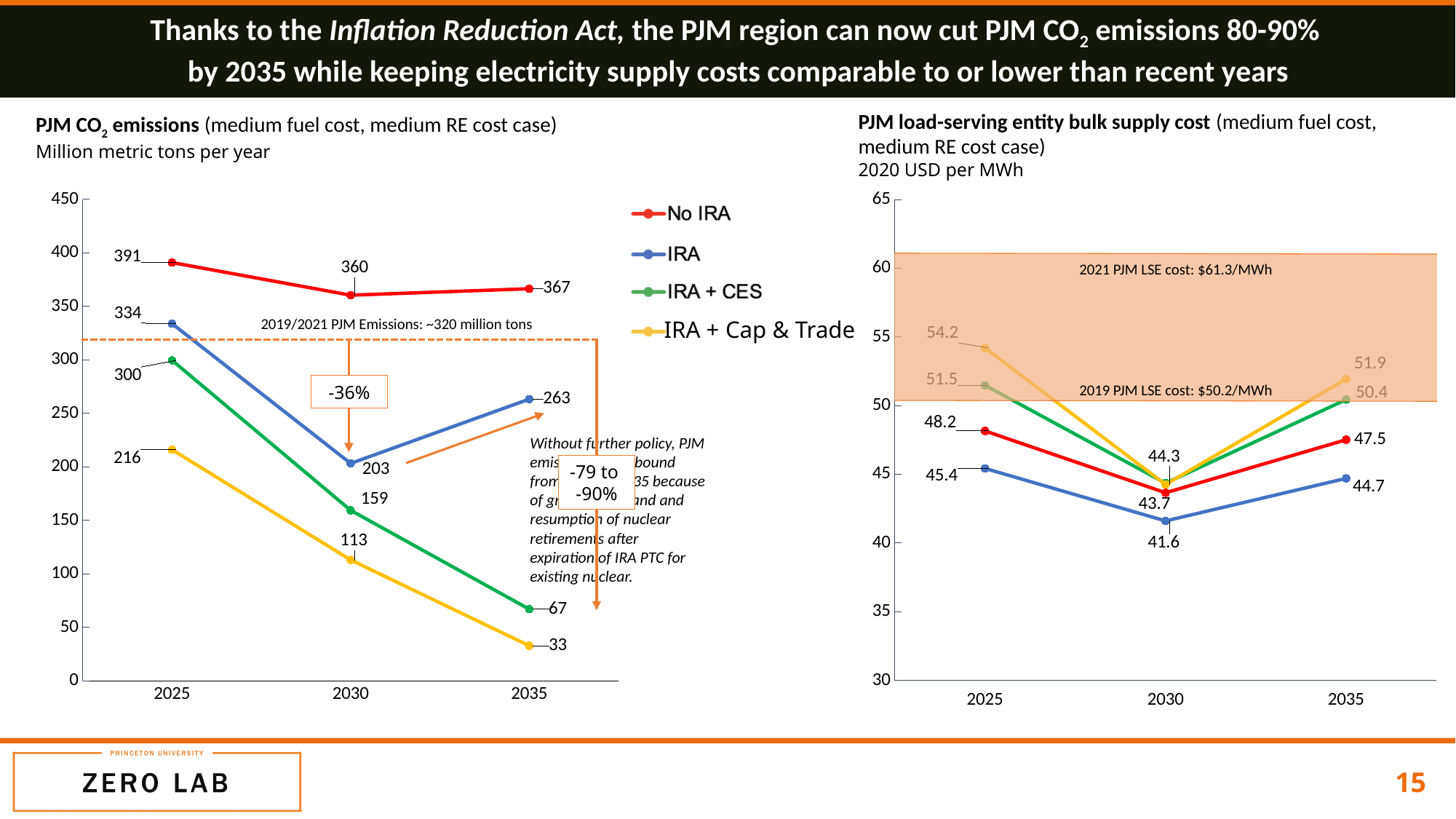
What kind of chart is the PJM load-serving entity bulk supply cost chart? line chart How many series does the legend list? 4 On the PJM CO2 emissions chart, what is the IRA value in 2030? 203 On the PJM load-serving entity bulk supply cost chart, what is the IRA value in 2030? 41.6 On the PJM CO2 emissions chart, does the IRA + CES series rise or fall from 2025 to 2035? fall On the PJM CO2 emissions chart, which series has the lowest value in 2035? IRA + Cap & Trade On the PJM CO2 emissions chart, what is the IRA + Cap & Trade value in 2035? 33 On the PJM CO2 emissions chart, what is the difference between the No IRA and IRA values in 2035? 104 On the PJM CO2 emissions chart, what is the No IRA value in 2025? 391 On the PJM load-serving entity bulk supply cost chart, which series has the highest value in 2025? IRA + Cap & Trade On the PJM load-serving entity bulk supply cost chart, is the IRA value in 2035 greater or less than 45? less On the PJM load-serving entity bulk supply cost chart, what is the No IRA value in 2035? 47.5